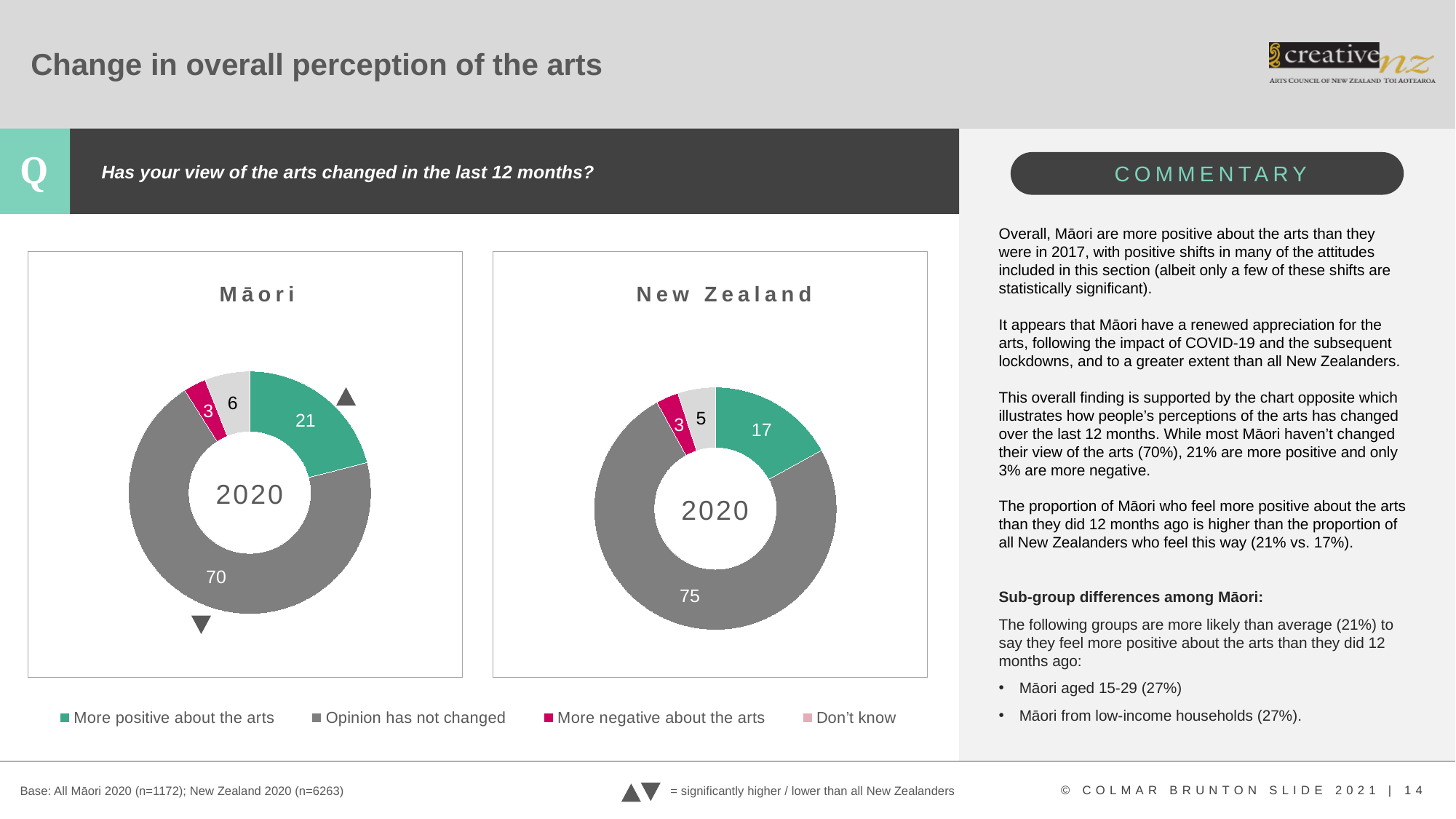
In the New Zealand chart, what is the value for 'Opinion has not changed'? 75 How many categories does the legend list for the charts? 4 In the New Zealand chart, what is the value for 'More negative about the arts'? 3 In the New Zealand chart, which category has the smallest value? More negative about the arts What year is shown in the centre of the New Zealand chart? 2020 In the Māori chart, what is the value for 'Don't know'? 6 Which chart has the larger value for 'Opinion has not changed', Māori or New Zealand? New Zealand What type of chart is the Māori chart? Doughnut chart What is the difference between the 'More positive about the arts' values in the Māori chart and the New Zealand chart? 4 In the Māori chart, what is the value for 'More positive about the arts'? 21 In the Māori chart, which category has the largest value? Opinion has not changed In the Māori chart, what is the difference between 'Opinion has not changed' and 'More positive about the arts'? 49